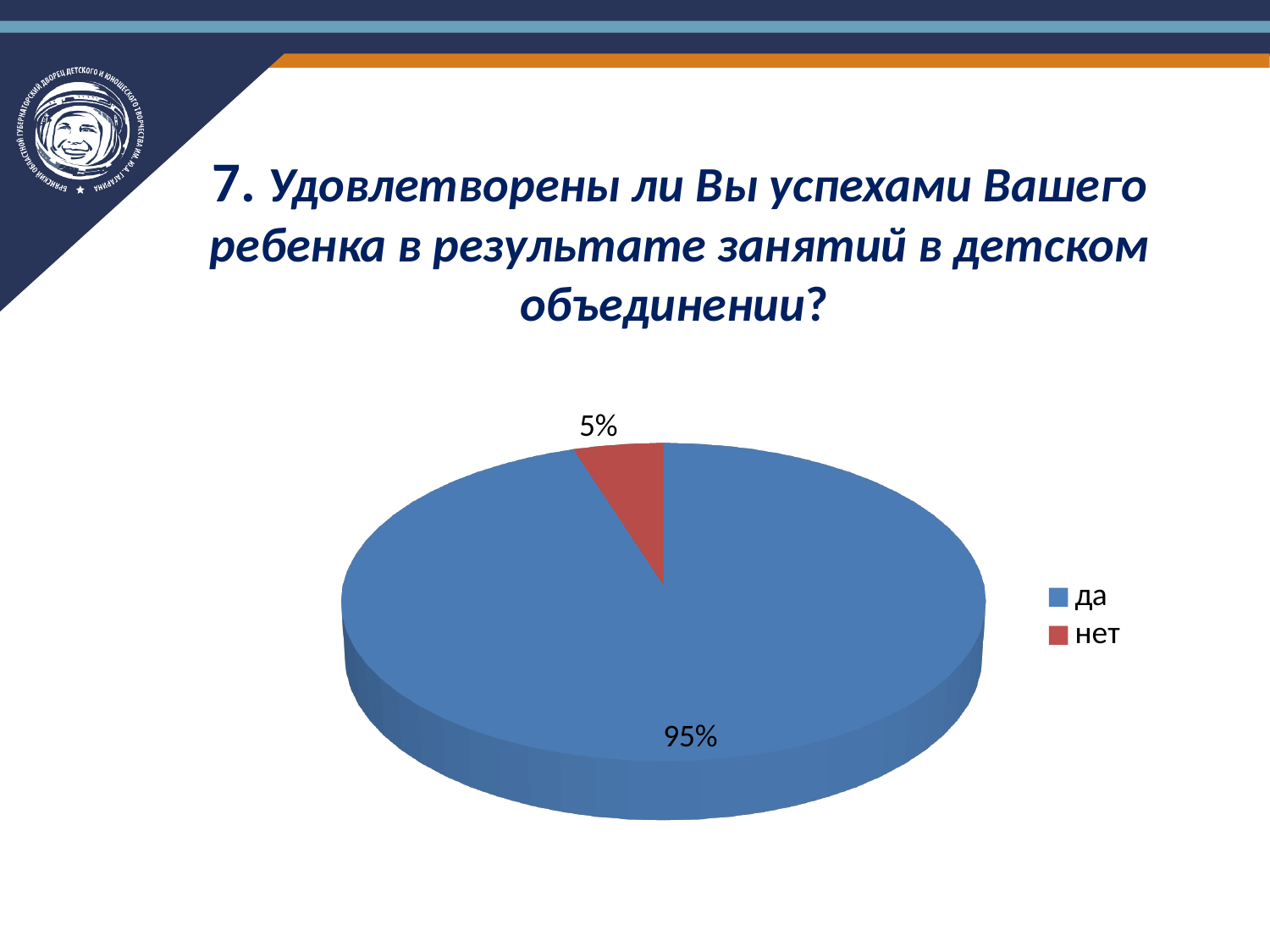
How many entries does the legend list? 2 What colour is the slice for "да"? blue What share of the pie does "да" take? 95% What is the difference in percentage points between "да" and "нет"? 90 What share of the pie does "нет" take? 5% What colour is the slice for "нет"? red Which category has the smallest slice of the pie? нет Which is larger, the slice for "да" or the slice for "нет"? да Which category has the largest slice of the pie? да How many slices does the pie chart have? 2 What kind of chart is shown on the slide? pie chart